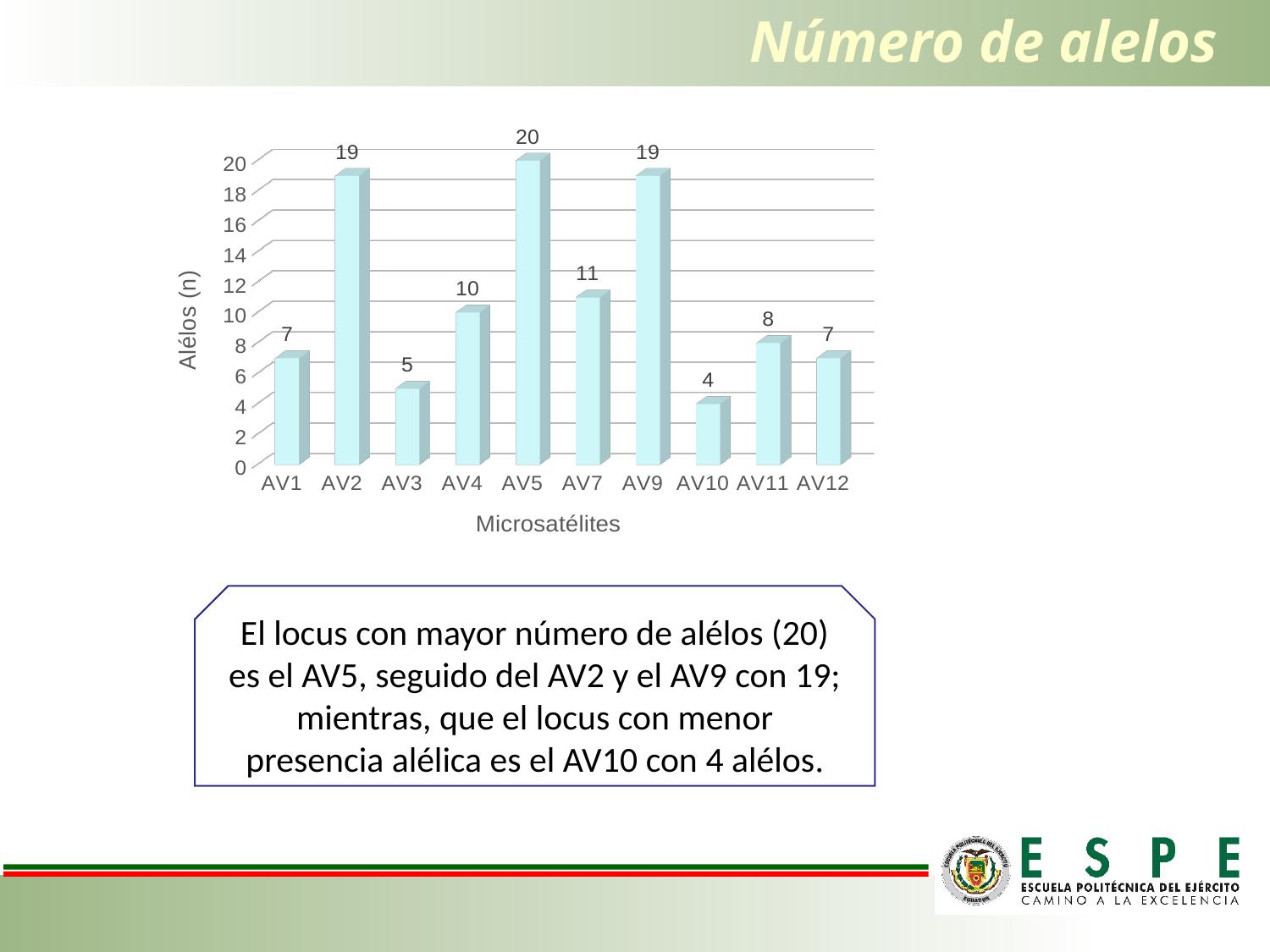
What is the number of alleles for AV10? 4 What is the number of alleles for AV7? 11 How many microsatellites are shown on the x axis? 10 What is the difference in number of alleles between AV5 and AV10? 16 What is the label of the y axis? Alélos (n) Which microsatellite has the lowest number of alleles? AV10 What is the difference in number of alleles between AV4 and AV3? 5 What is the label of the x axis? Microsatélites Which has more alleles, AV11 or AV12? AV11 Which microsatellite has the highest number of alleles? AV5 What kind of chart is shown on the slide? Bar chart What is the number of alleles for AV5? 20